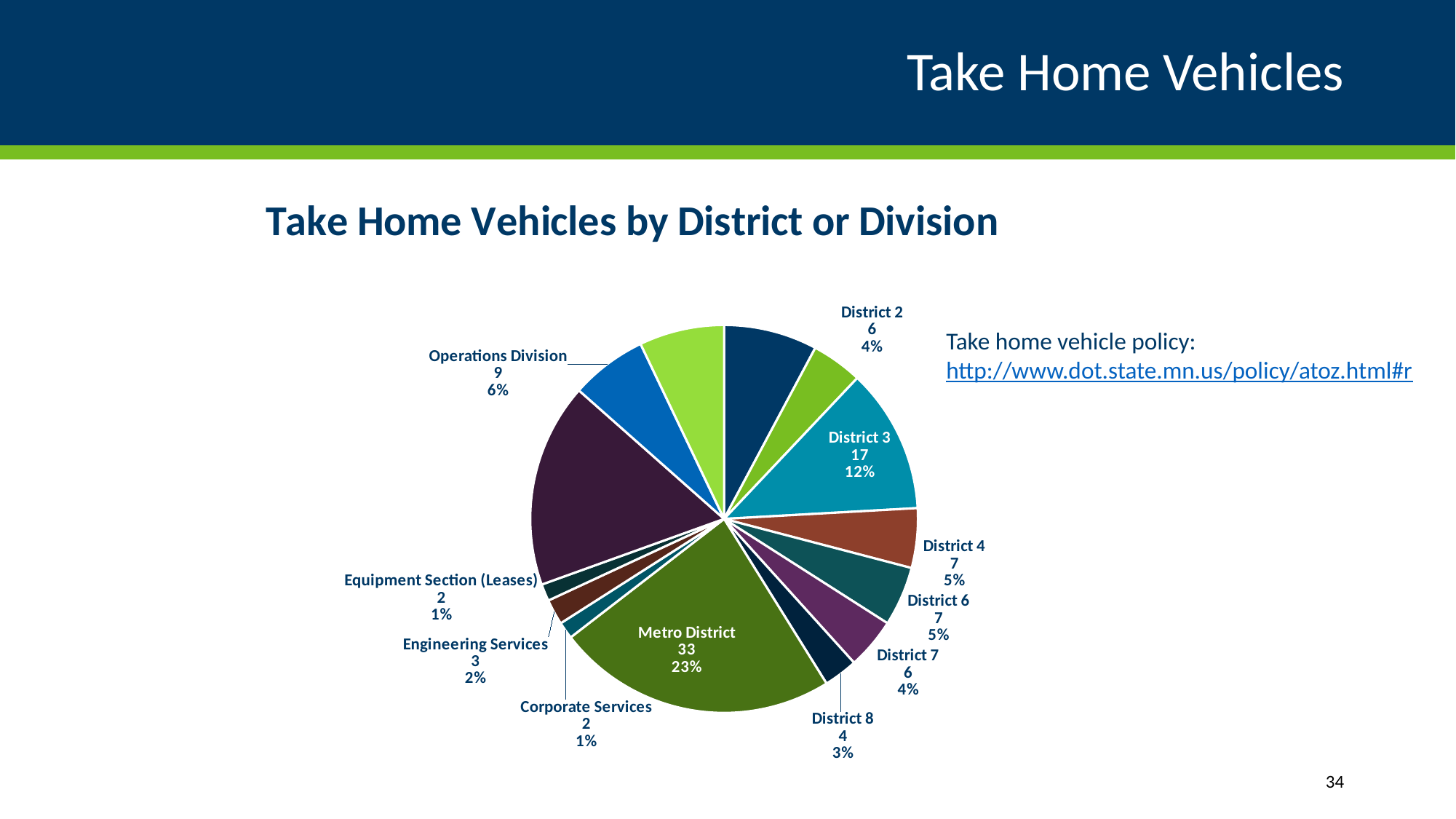
What percentage of take home vehicles belongs to District 8? 3% What is the difference in take home vehicles between Engineering Services and Corporate Services? 1 What type of chart is shown on the slide? pie chart How many take home vehicles does the Metro District have? 33 What share of the pie does the Metro District slice represent? 23% What is the difference in take home vehicles between the Metro District and District 3? 16 How many take home vehicles does the Operations Division have? 9 Which has more take home vehicles, Operations Division or District 7? Operations Division Which has more take home vehicles, District 4 or District 8? District 4 How many take home vehicles does District 3 have? 17 What is the title of the chart? Take Home Vehicles by District or Division What percentage of take home vehicles belongs to District 3? 12%